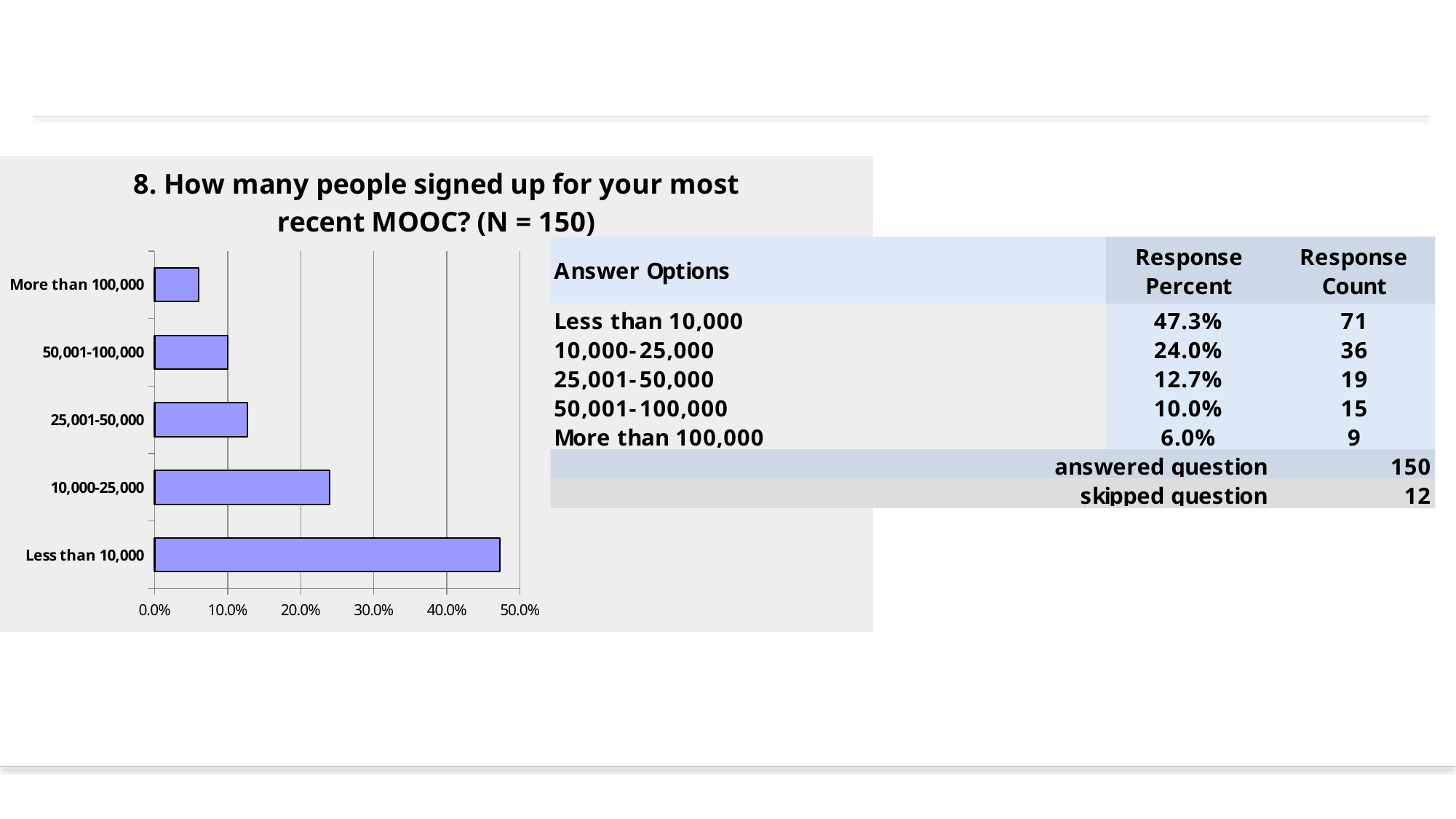
Is the value for 10,000-25,000 greater or less than 20.0%? greater What kind of chart is shown on the slide? bar chart What is the response percent for Less than 10,000? 47.3% What is the response percent for 50,001-100,000? 10.0% Is the value for More than 100,000 greater or less than 10.0%? less What is the response count for 10,000-25,000? 36 Which is larger, the value for 25,001-50,000 or the value for 50,001-100,000? 25,001-50,000 What is the title of the chart? 8. How many people signed up for your most recent MOOC? (N = 150) Which category has the highest response percent? Less than 10,000 Which category has the lowest response percent? More than 100,000 What is the difference in response percent between Less than 10,000 and 10,000-25,000? 23.3% How many categories does the bar chart show? 5